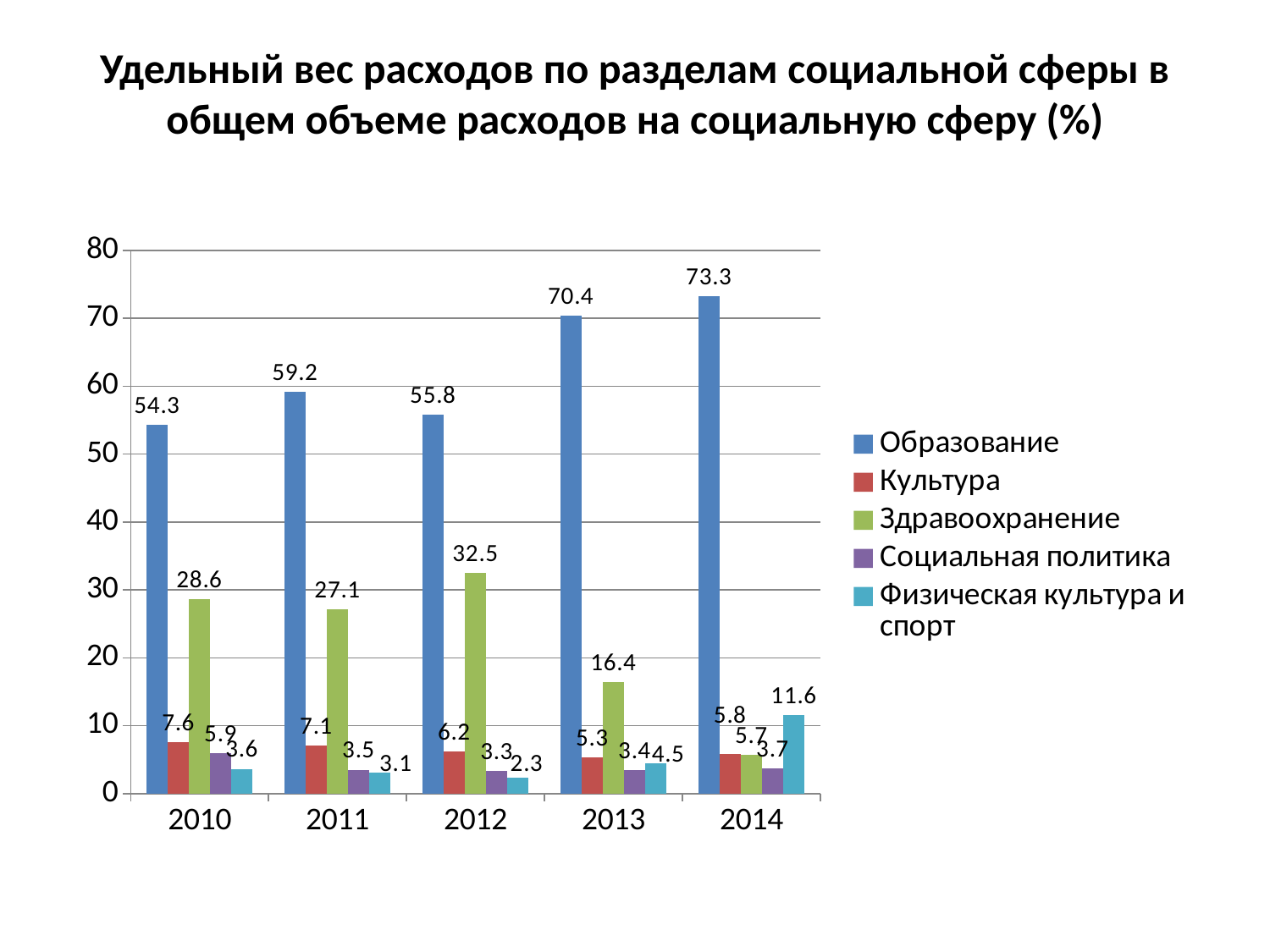
In which year is the value for Образование the highest? 2014 Which is larger in 2013: Здравоохранение or Культура? Здравоохранение What is the value for Образование in 2014? 73.3 Is the value for Образование in 2013 greater or less than 70? greater How many series does the legend list? 5 How many years are shown on the x axis? 5 What is the value for Культура in 2010? 7.6 In which year is the value for Физическая культура и спорт the lowest? 2012 What is the value for Физическая культура и спорт in 2014? 11.6 What is the value for Здравоохранение in 2012? 32.5 What kind of chart is shown on the slide? bar chart What is the difference between the Образование values for 2014 and 2010? 19